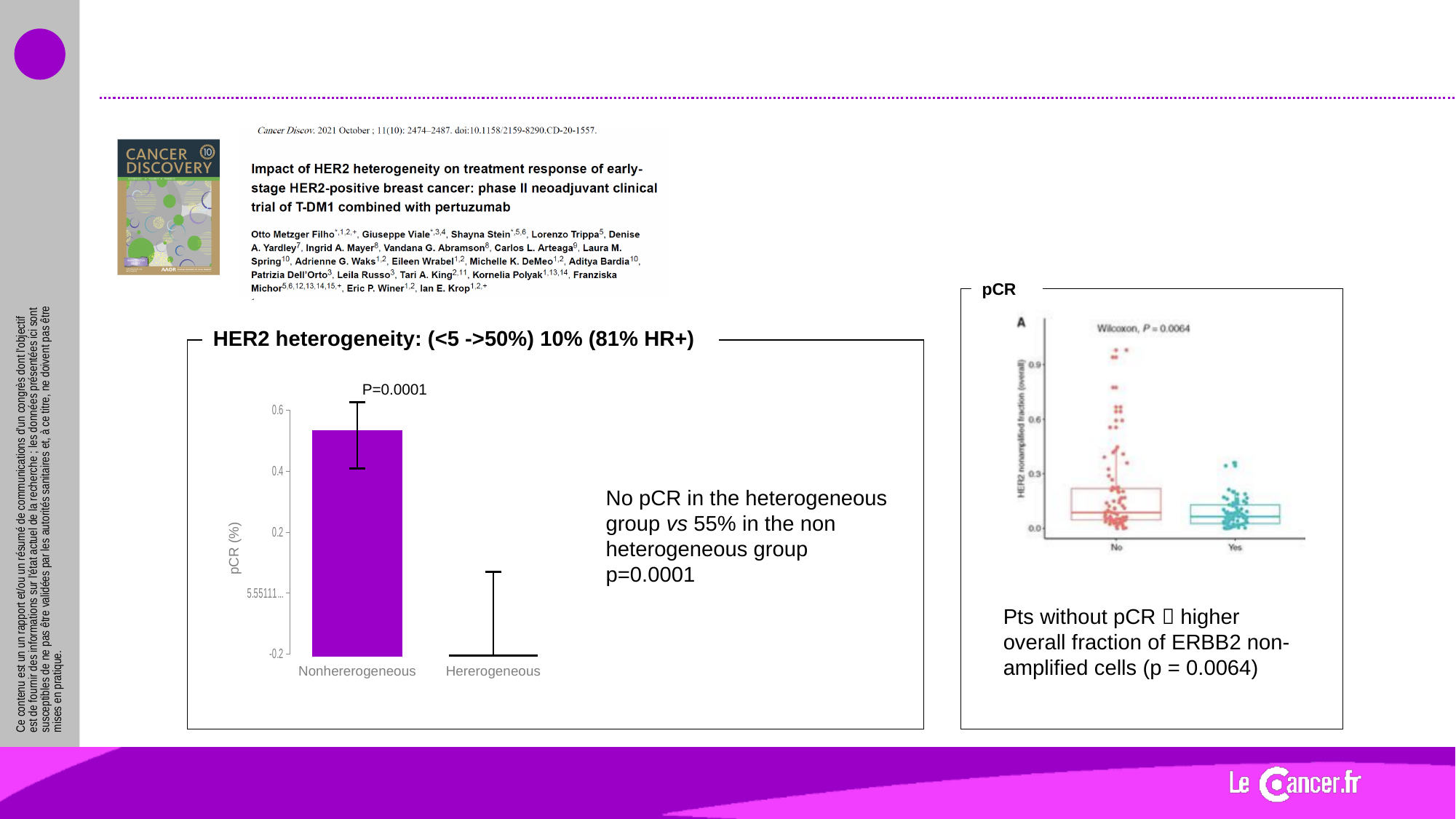
In the pCR box plot on the right, is the highest data point in the 'No' group greater or less than 0.9? greater In the bar chart on the left, which category has the lowest pCR value? Hererogeneous In the pCR box plot on the right, how many groups are shown on the x axis? 2 In the bar chart on the left, how many categories are shown on the x axis? 2 In the bar chart on the left, is the value for Nonhererogeneous greater or less than 0.6? less In the bar chart on the left, which category has the highest pCR value? Nonhererogeneous In the pCR box plot on the right, which group contains the highest individual data point? No In the bar chart on the left, what P value is printed above the bars? P=0.0001 In the bar chart on the left, is the value for Nonhererogeneous greater or less than 0.4? greater What kind of chart is the chart titled 'HER2 heterogeneity: (<5 ->50%) 10% (81% HR+)'? bar chart In the pCR box plot on the right, what Wilcoxon P value is printed at the top of the plot? P = 0.0064